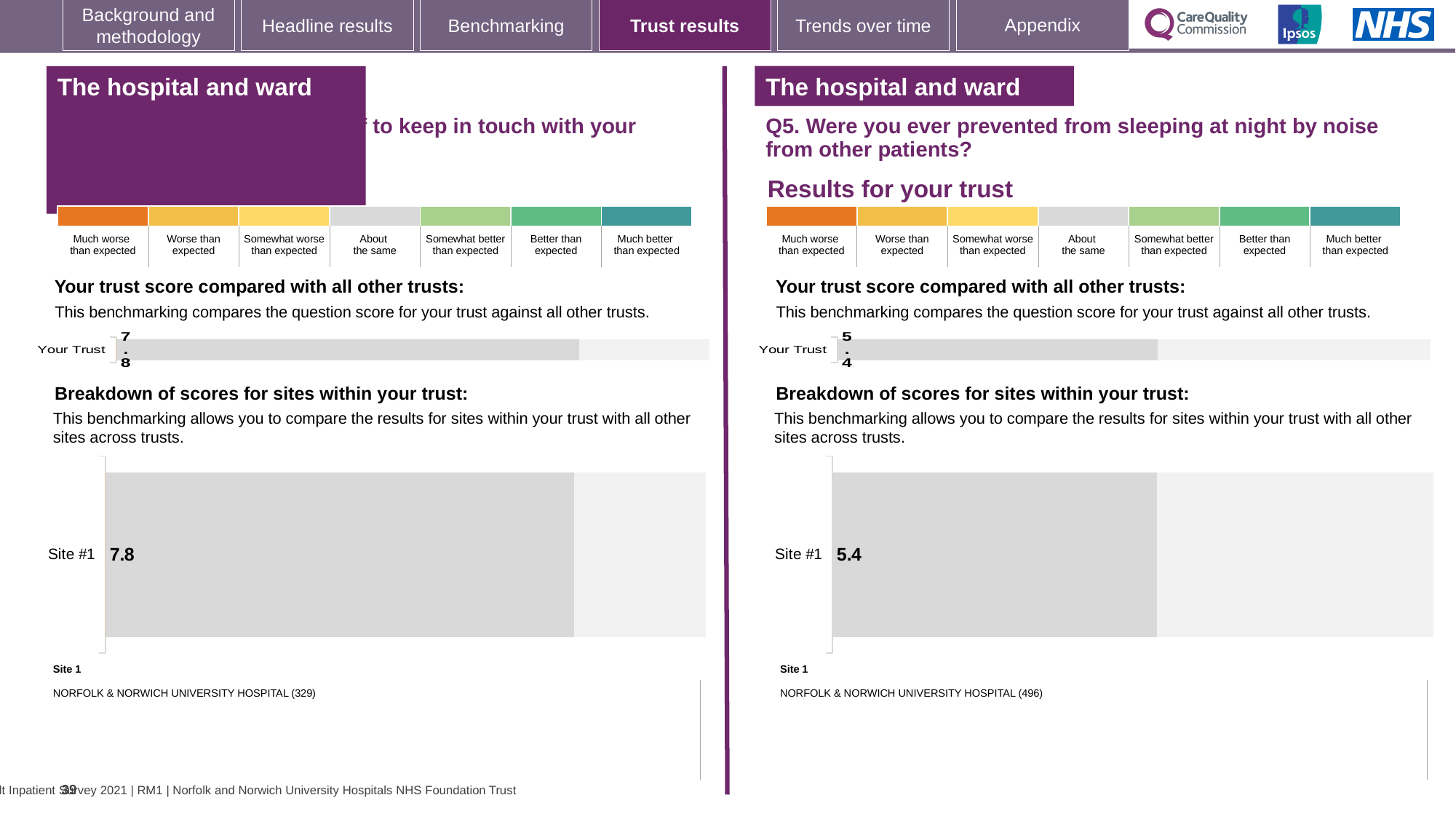
What is the difference between the Site #1 score on the left-hand panel and the Site #1 score on the right-hand panel (Q5)? 2.4 On the left-hand panel, what is the score shown for 'Your Trust' in the trust comparison bar chart? 7.8 On the right-hand panel (Q5), how many sites are shown in the breakdown of scores for sites chart? 1 On the left-hand panel, what score is shown for Site #1 in the breakdown of scores for sites chart? 7.8 What type of chart is used to show the 'Your Trust' score on each panel? Bar chart On the right-hand panel (Q5), what number appears in parentheses after the Site 1 hospital name? 496 On the left-hand panel, how many sites are shown in the breakdown of scores for sites chart? 1 On the right-hand panel (Q5), which hospital is listed as Site 1 below the breakdown chart? NORFOLK & NORWICH UNIVERSITY HOSPITAL On the right-hand panel (Q5), what is the score shown for 'Your Trust' in the trust comparison bar chart? 5.4 On the right-hand panel (Q5), what score is shown for Site #1 in the breakdown of scores for sites chart? 5.4 Which panel shows the higher Site #1 score, the left-hand panel or the right-hand panel (Q5)? Left-hand panel Which panel shows the higher 'Your Trust' score, the left-hand panel or the right-hand panel (Q5)? Left-hand panel